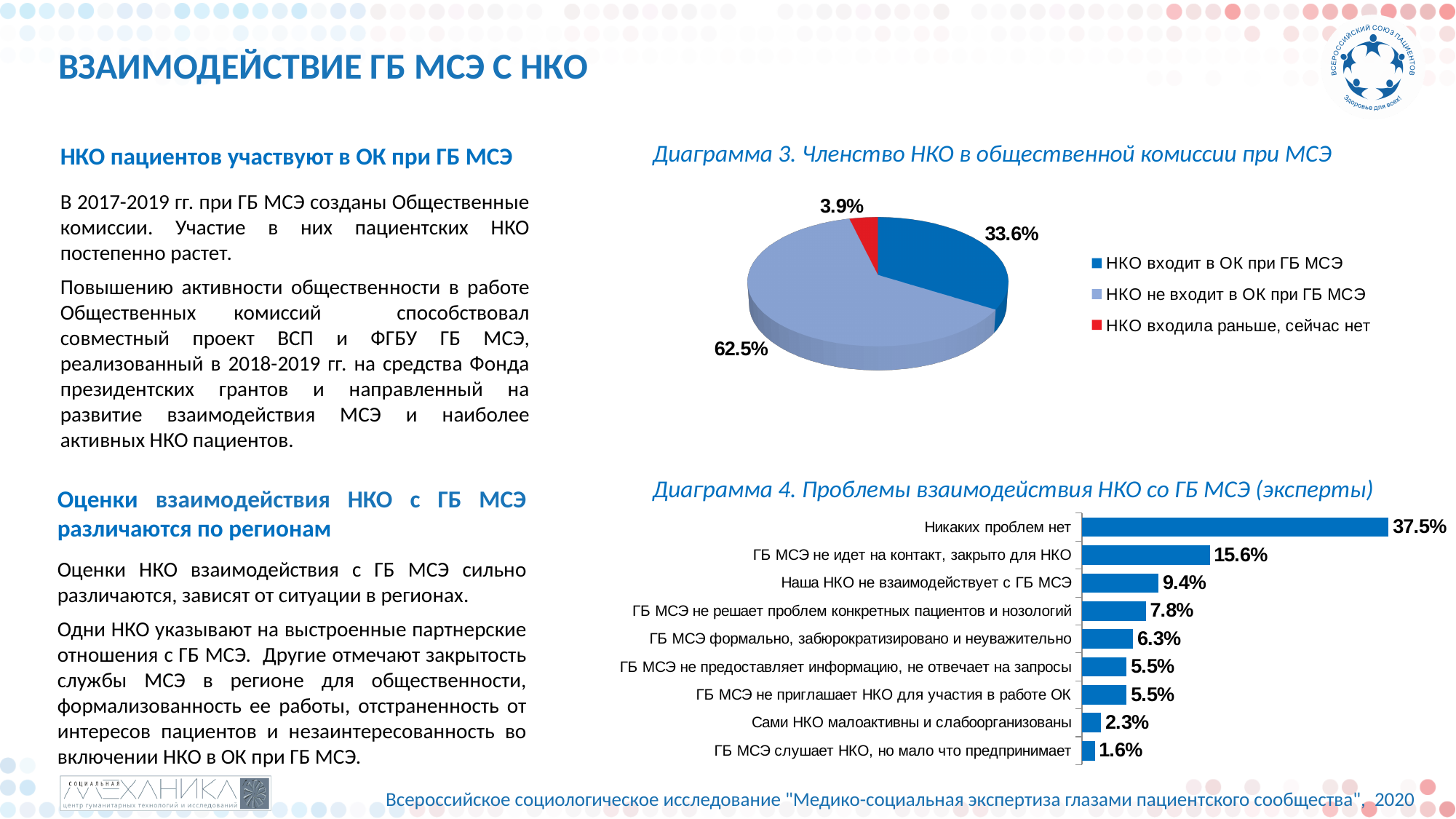
In the chart 'Диаграмма 3. Членство НКО в общественной комиссии при МСЭ', how many categories does the legend list? 3 What kind of chart is 'Диаграмма 3. Членство НКО в общественной комиссии при МСЭ'? Pie chart In the chart 'Диаграмма 3. Членство НКО в общественной комиссии при МСЭ', what colour is the slice for 'НКО входила раньше, сейчас нет'? Red In the chart 'Диаграмма 4. Проблемы взаимодействия НКО со ГБ МСЭ (эксперты)', what is the difference between 'Никаких проблем нет' and 'ГБ МСЭ не идет на контакт, закрыто для НКО'? 21.9% In the chart 'Диаграмма 4. Проблемы взаимодействия НКО со ГБ МСЭ (эксперты)', how many categories are shown? 9 In the chart 'Диаграмма 4. Проблемы взаимодействия НКО со ГБ МСЭ (эксперты)', what is the value for 'ГБ МСЭ не идет на контакт, закрыто для НКО'? 15.6% In the chart 'Диаграмма 4. Проблемы взаимодействия НКО со ГБ МСЭ (эксперты)', which category has the lowest value? ГБ МСЭ слушает НКО, но мало что предпринимает What kind of chart is 'Диаграмма 4. Проблемы взаимодействия НКО со ГБ МСЭ (эксперты)'? Bar chart In the chart 'Диаграмма 4. Проблемы взаимодействия НКО со ГБ МСЭ (эксперты)', what is the value for 'Никаких проблем нет'? 37.5% In the chart 'Диаграмма 3. Членство НКО в общественной комиссии при МСЭ', which category has the smallest slice? НКО входила раньше, сейчас нет In the chart 'Диаграмма 3. Членство НКО в общественной комиссии при МСЭ', what share is labelled for 'НКО входит в ОК при ГБ МСЭ'? 33.6% In the chart 'Диаграмма 3. Членство НКО в общественной комиссии при МСЭ', what share is labelled for 'НКО не входит в ОК при ГБ МСЭ'? 62.5%